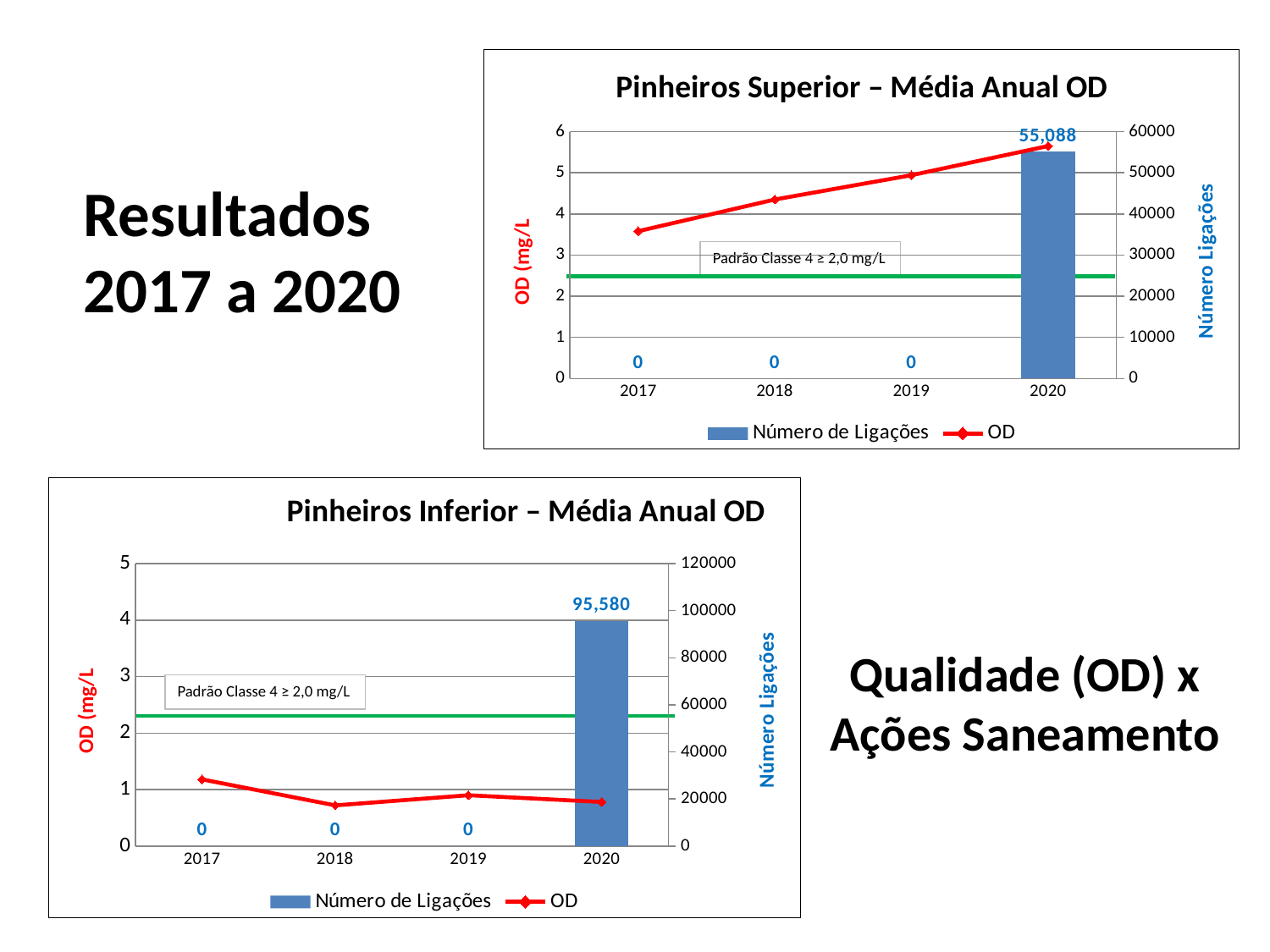
In the 'Pinheiros Inferior – Média Anual OD' chart, is the OD value for 2018 greater or less than 1? less In the 'Pinheiros Inferior – Média Anual OD' chart, which year has the highest OD value? 2017 How many years are shown on the x axis of the 'Pinheiros Superior – Média Anual OD' chart? 4 In the 'Pinheiros Superior – Média Anual OD' chart, is the OD value for 2020 greater or less than 5? greater In the 'Pinheiros Superior – Média Anual OD' chart, what is the Número de Ligações value for 2020? 55,088 In the 'Pinheiros Superior – Média Anual OD' chart, does the OD line rise or fall from 2017 to 2020? rise What is the difference between the 2020 Número de Ligações in the 'Pinheiros Inferior' chart and the 2020 value in the 'Pinheiros Superior' chart? 40,492 In the 'Pinheiros Inferior – Média Anual OD' chart, does the OD line rise or fall from 2017 to 2020? fall In the 'Pinheiros Superior – Média Anual OD' chart, what is the Número de Ligações value for 2018? 0 In the 'Pinheiros Inferior – Média Anual OD' chart, what is the Número de Ligações value for 2020? 95,580 How many series does the legend of the 'Pinheiros Inferior – Média Anual OD' chart list? 2 Which chart shows the larger Número de Ligações value for 2020, 'Pinheiros Superior' or 'Pinheiros Inferior'? Pinheiros Inferior